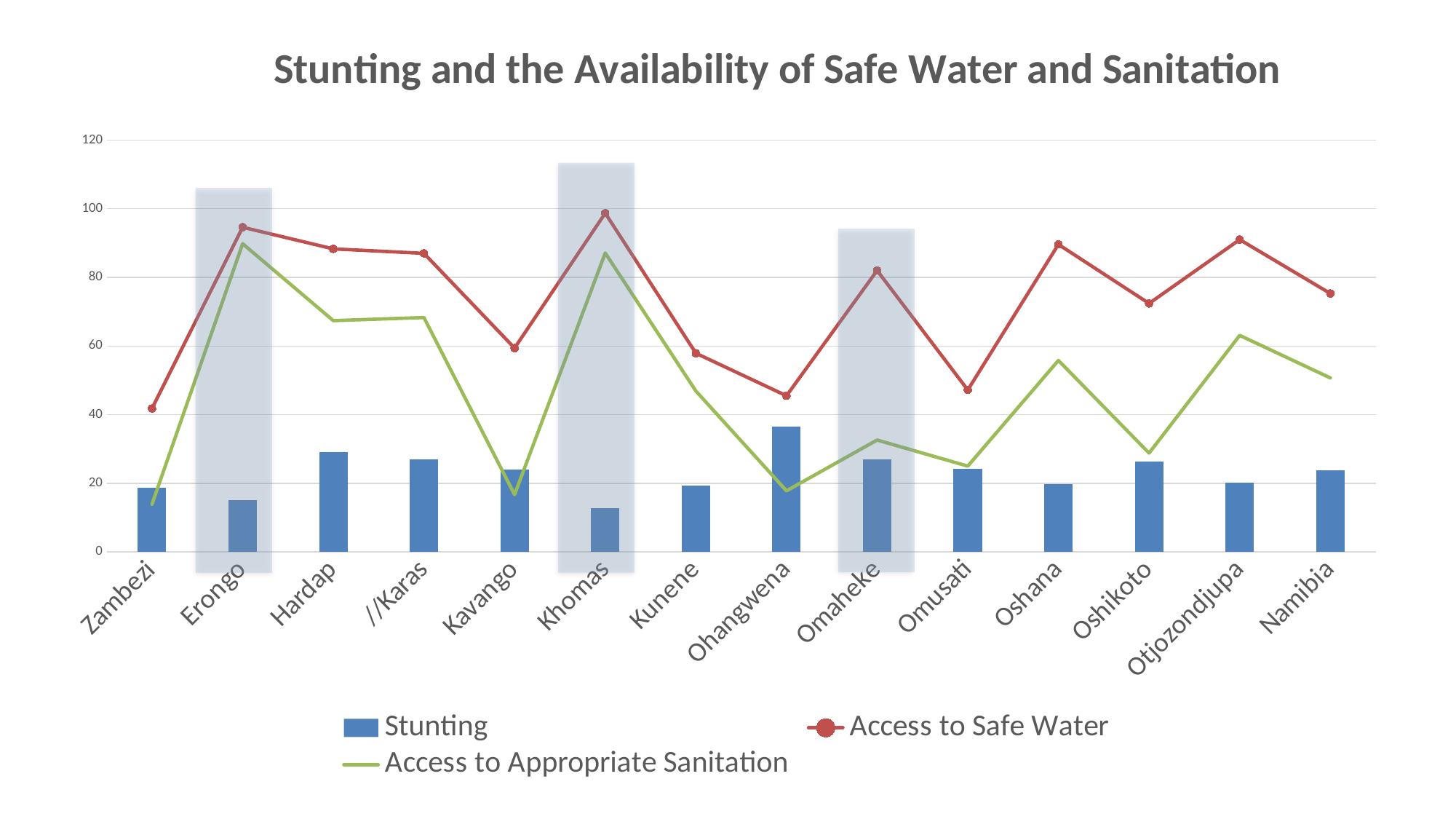
Which category has the highest Stunting value? Ohangwena Which has the larger Stunting value, Hardap or Kunene? Hardap Is the Access to Safe Water value for Zambezi greater or less than 60? less Is the Stunting value for Ohangwena greater or less than 20? greater What is the title of the chart? Stunting and the Availability of Safe Water and Sanitation Is the Access to Safe Water value for Oshana greater or less than 80? greater Which category has the highest Access to Safe Water value? Khomas What kind of chart is this? Combined bar and line chart Which has the larger Access to Appropriate Sanitation value, Hardap or Oshikoto? Hardap How many categories are shown on the x axis? 14 How many series does the legend list? 3